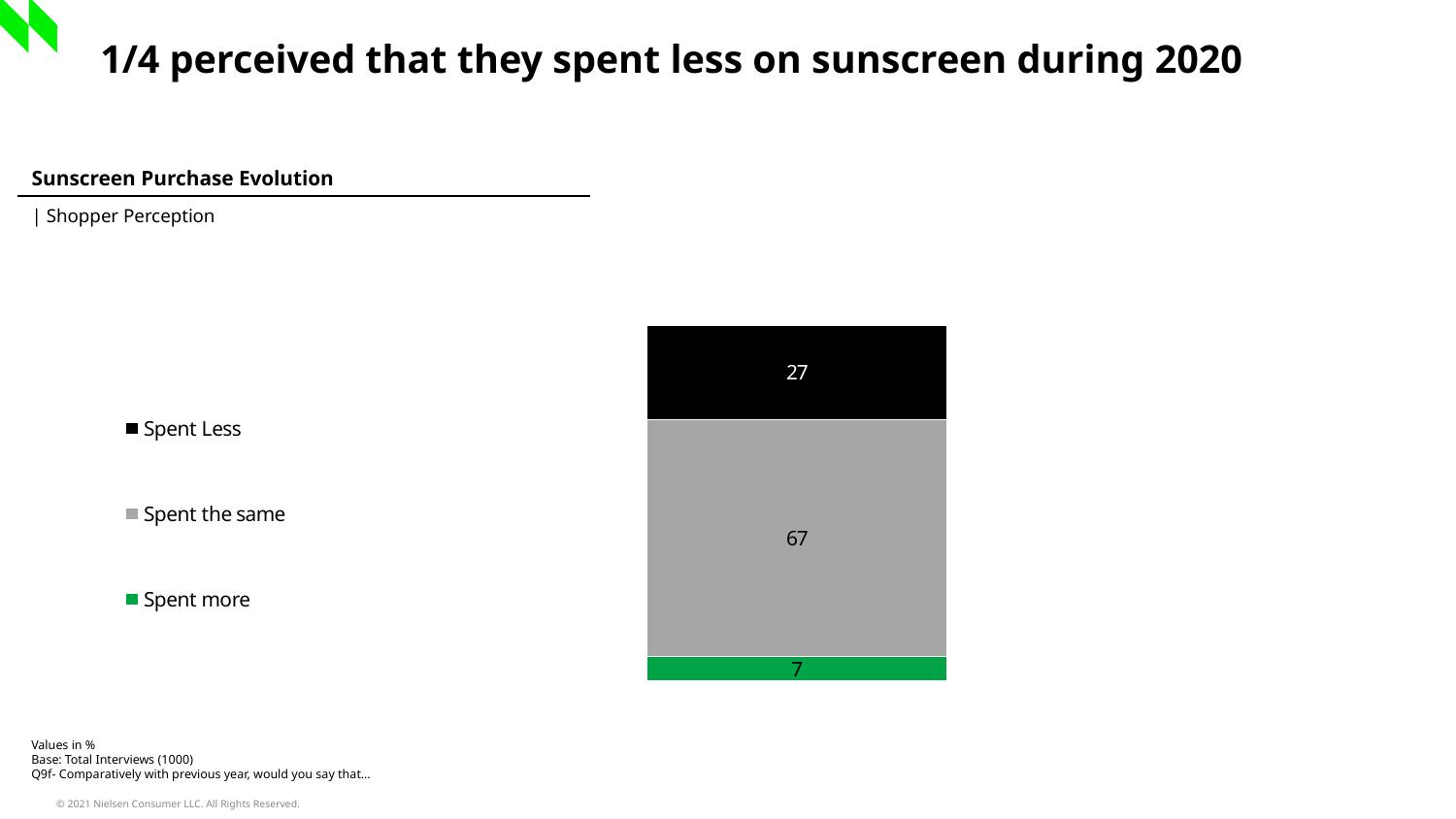
What value is shown for the Spent more segment of the stacked bar? 7 What kind of chart is shown on the slide? Stacked bar chart What colour is the Spent more segment in the chart? Green How many series does the legend list? 3 What is the difference between the Spent the same value and the Spent Less value? 40 Which segment of the stacked bar has the largest value? Spent the same Which is larger, the value for Spent Less or the value for Spent more? Spent Less What is the total of the three segments in the stacked bar? 101 What value is shown for the Spent Less segment of the stacked bar? 27 What is the difference between the Spent Less value and the Spent more value? 20 Which segment of the stacked bar has the smallest value? Spent more What value is shown for the Spent the same segment of the stacked bar? 67